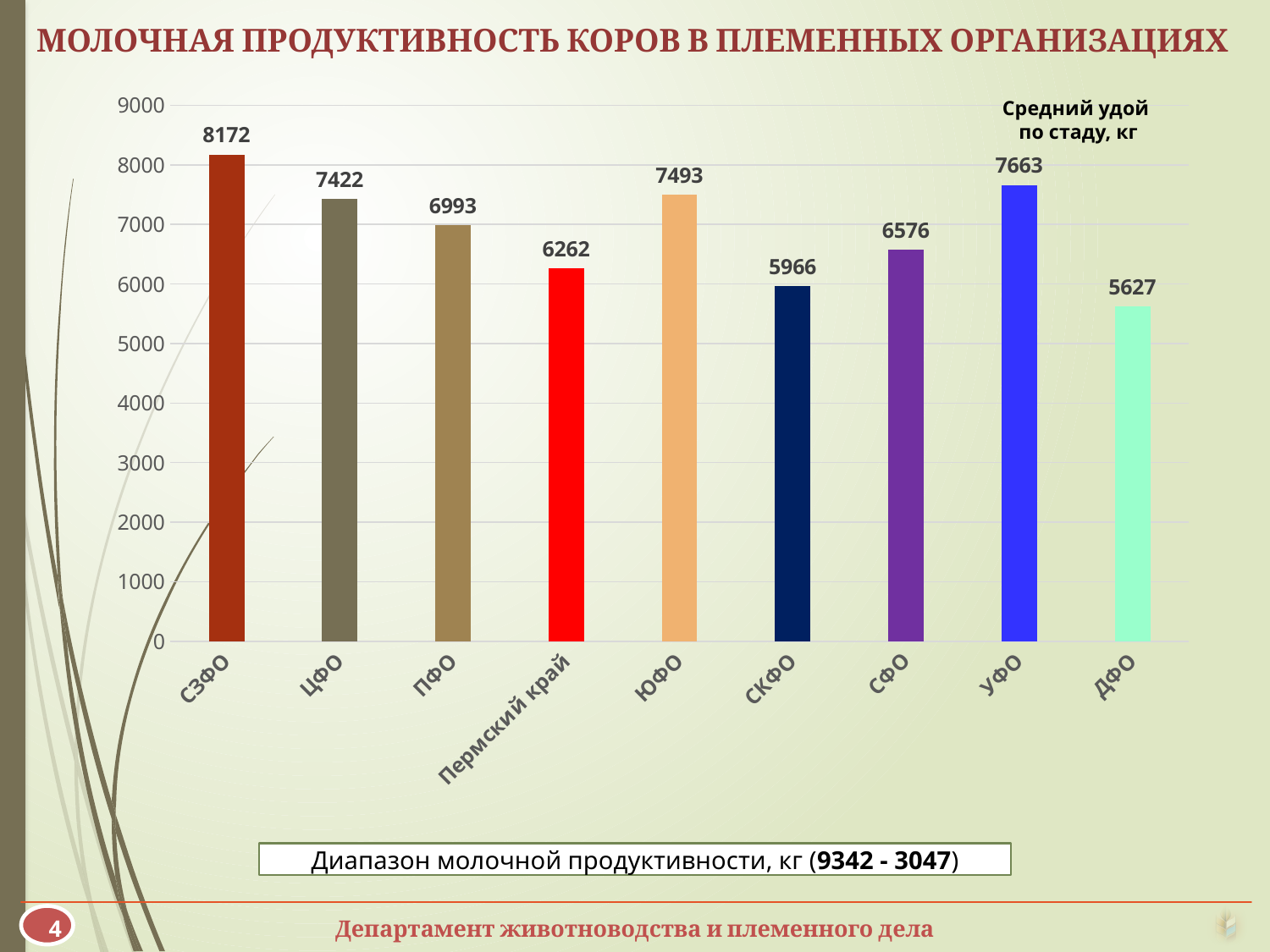
Which category has the highest value? СЗФО Which category has the lowest value? ДФО What is the difference between the values for СЗФО and ДФО? 2545 What is the value for ДФО? 5627 What is the difference between the values for УФО and ЮФО? 170 What is the value for СЗФО? 8172 What kind of chart is shown on the slide? bar chart What is the value for Пермский край? 6262 Which is larger, the value for ЦФО or the value for ПФО? ЦФО How many categories are shown on the x axis? 9 Is the value for СКФО greater or less than 6000? less What is the title of the chart? МОЛОЧНАЯ ПРОДУКТИВНОСТЬ КОРОВ В ПЛЕМЕННЫХ ОРГАНИЗАЦИЯХ